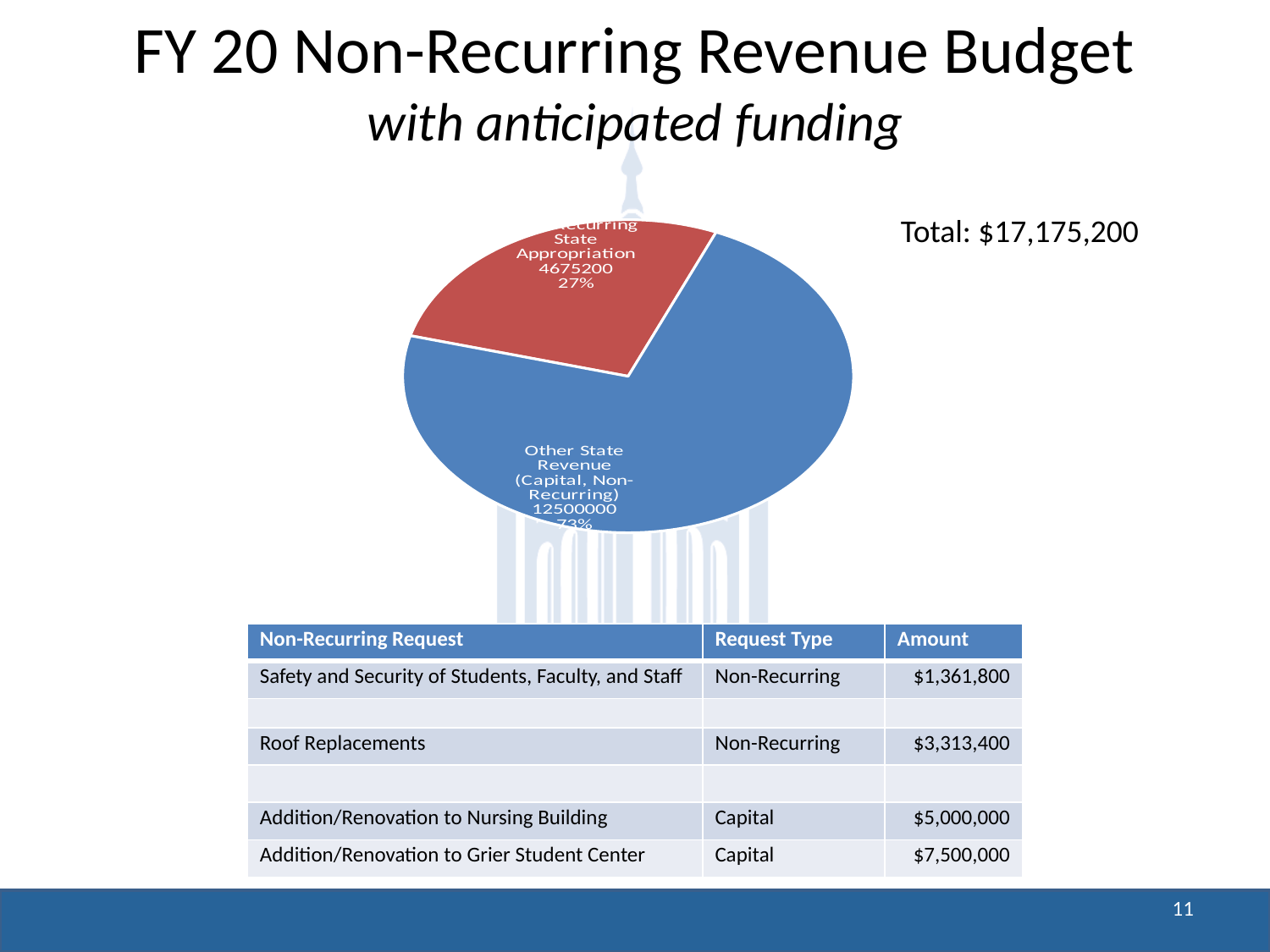
Which slice of the pie chart is the smallest? State Appropriation What colour is the Other State Revenue (Capital, Non-Recurring) slice? blue What total is shown next to the pie chart? $17,175,200 What is the difference between the Other State Revenue (Capital, Non-Recurring) value and the State Appropriation value? 7824800 How many slices does the pie chart have? 2 Which slice of the pie chart is the largest? Other State Revenue (Capital, Non-Recurring) What value is labelled on the State Appropriation slice? 4675200 What percentage share does the Other State Revenue (Capital, Non-Recurring) slice have? 73% What kind of chart is shown on the slide? pie chart What value is labelled on the Other State Revenue (Capital, Non-Recurring) slice? 12500000 Which is larger, the Other State Revenue (Capital, Non-Recurring) slice or the State Appropriation slice? Other State Revenue (Capital, Non-Recurring) What percentage share does the State Appropriation slice have? 27%